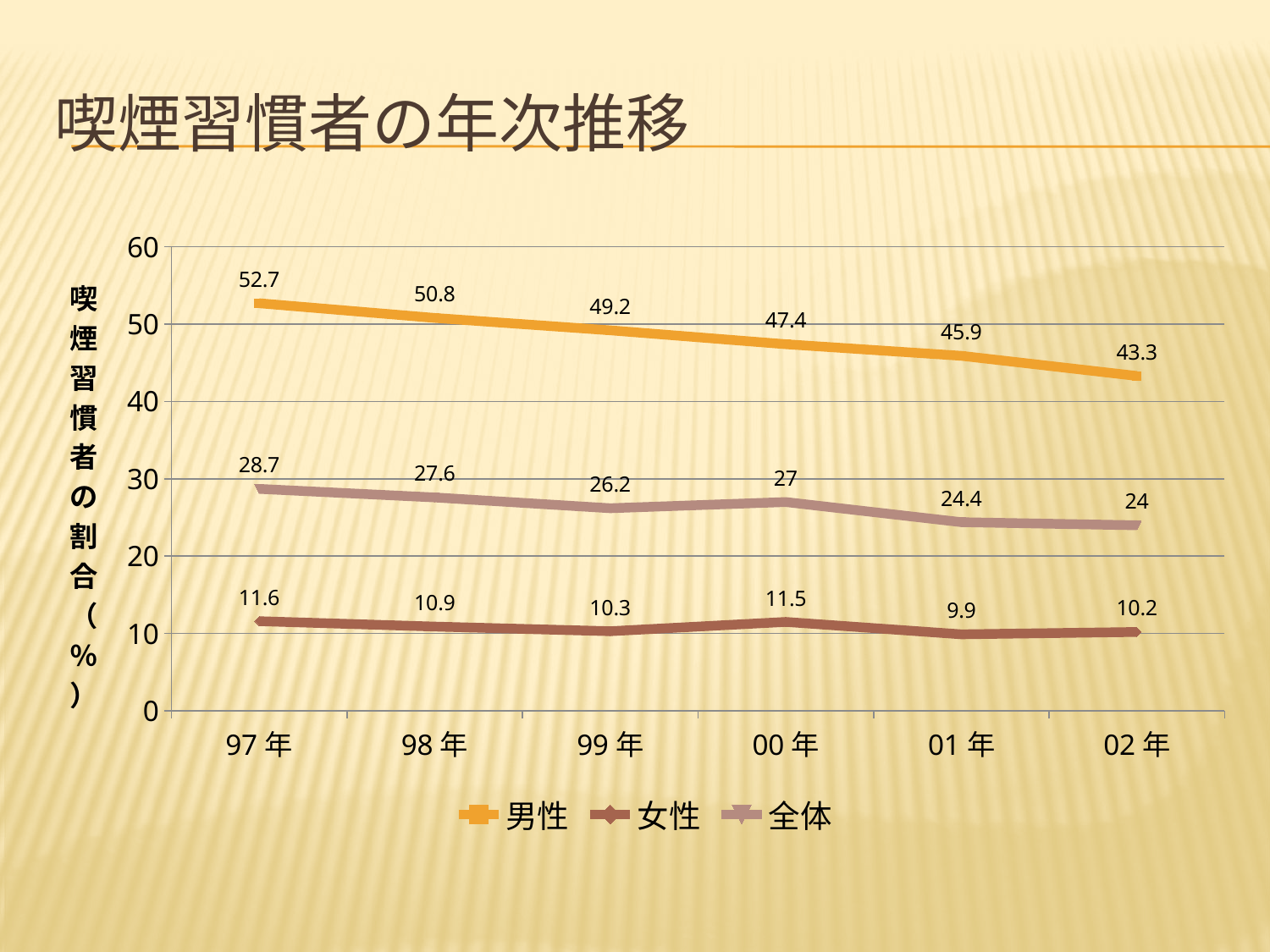
Does the 男性 series rise or fall from 97年 to 02年? fall In which year is the 女性 value lowest? 01年 In which year is the 男性 value highest? 97年 What is the title of the slide? 喫煙習慣者の年次推移 What is the value for 女性 in 00年? 11.5 What is the difference between the 男性 values in 97年 and 02年? 9.4 What is the value for 全体 in 02年? 24 How many series does the legend list? 3 How many years are shown on the x axis? 6 What is the value for 男性 in 97年? 52.7 What kind of chart is shown on the slide? line chart Which is larger, the 全体 value in 99年 or in 00年? 00年